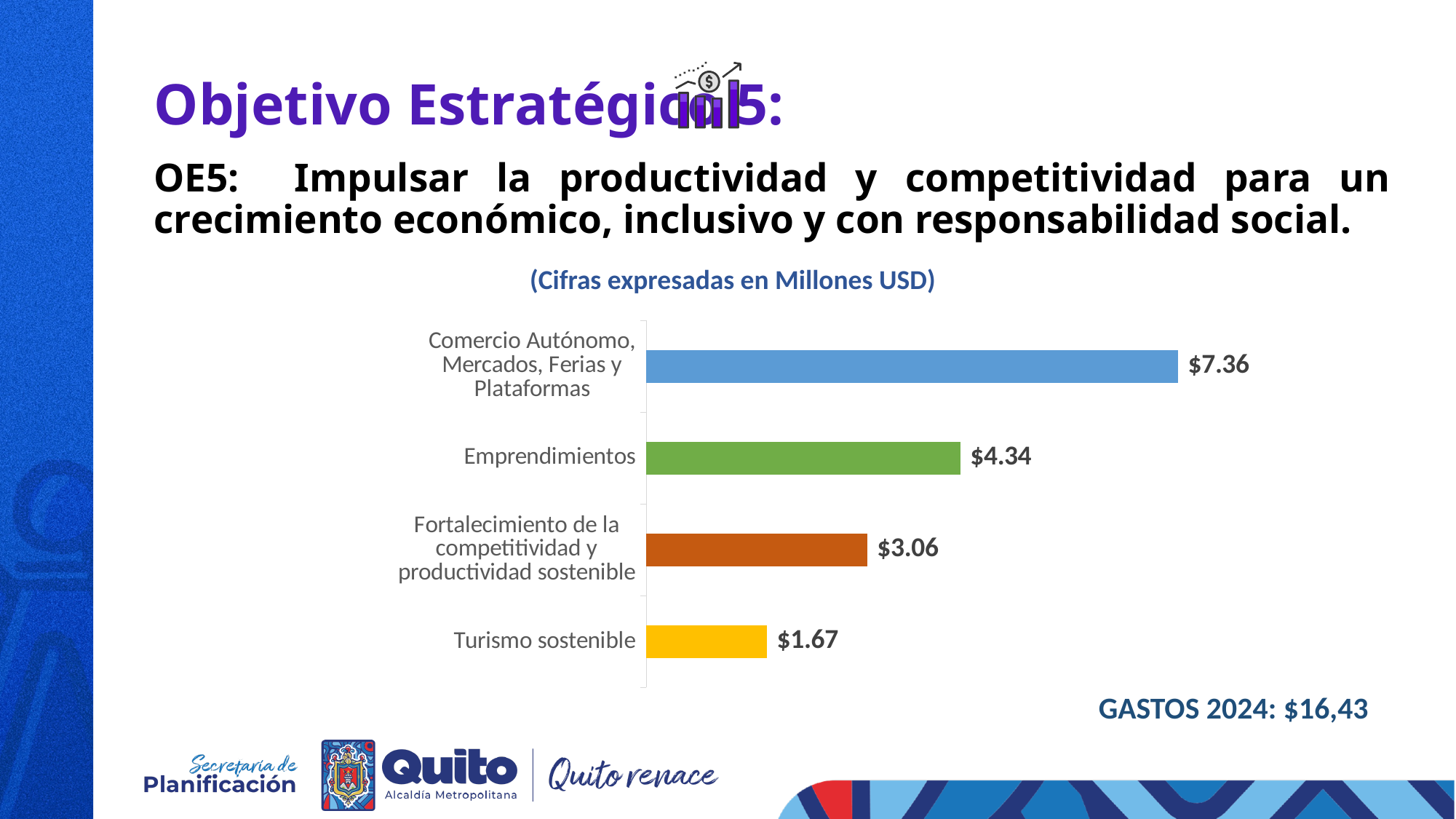
What is the difference between the values for Fortalecimiento de la competitividad y productividad sostenible and Turismo sostenible? $1.39 Which category has the highest value? Comercio Autónomo, Mercados, Ferias y Plataformas Which category has the lowest value? Turismo sostenible In what units are the figures in the chart expressed, according to the subtitle? Millones USD Which is larger, the value for Emprendimientos or the value for Fortalecimiento de la competitividad y productividad sostenible? Emprendimientos What is the difference between the values for Comercio Autónomo, Mercados, Ferias y Plataformas and Emprendimientos? $3.02 What is the value for Emprendimientos? $4.34 What is the value for Fortalecimiento de la competitividad y productividad sostenible? $3.06 How many categories are shown in the chart? 4 What kind of chart is shown on the slide? Bar chart What is the value for Comercio Autónomo, Mercados, Ferias y Plataformas? $7.36 What is the value for Turismo sostenible? $1.67